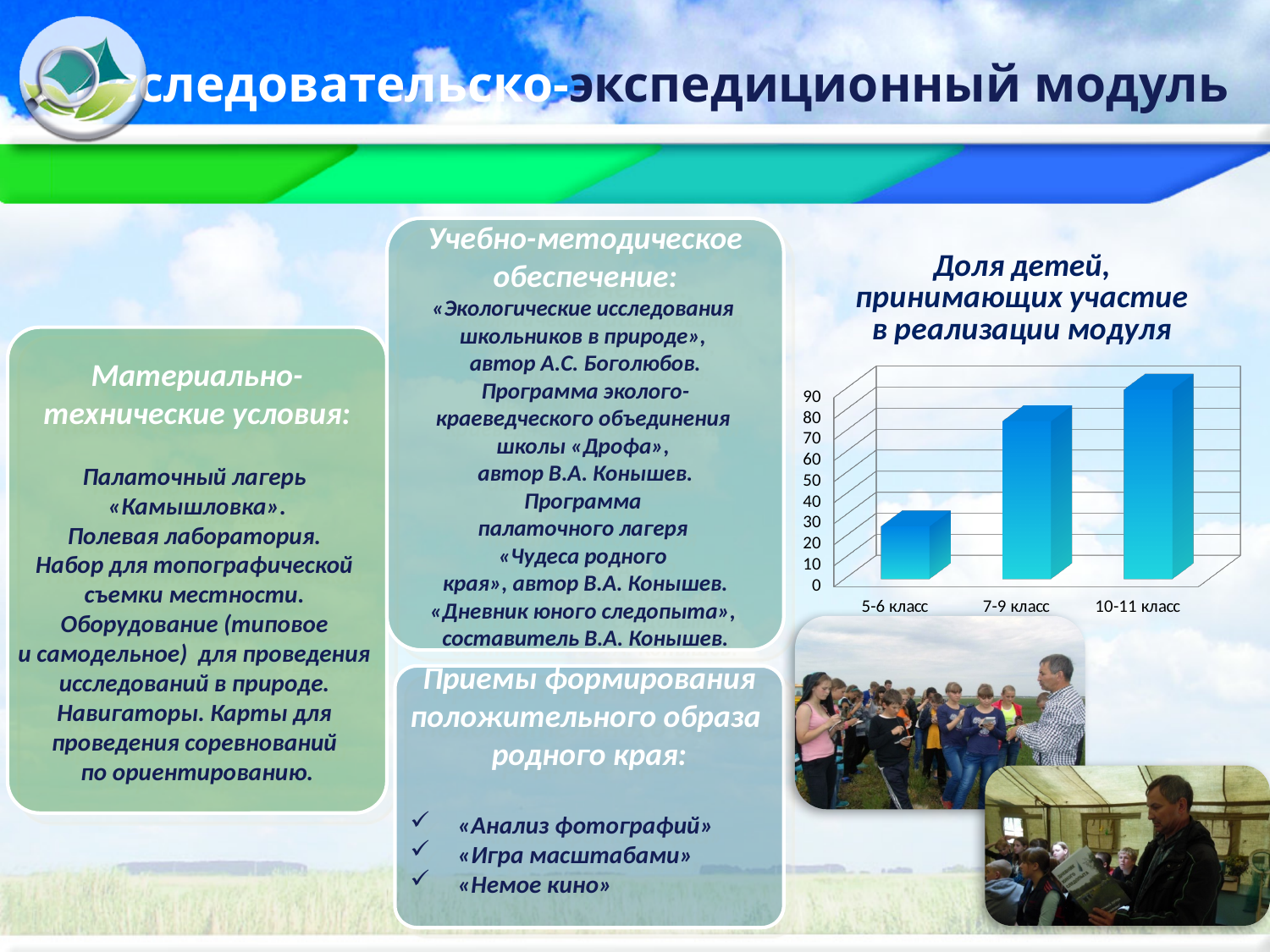
What is the title of the chart on the slide? Доля детей, принимающих участие в реализации модуля What is the highest tick value shown on the vertical axis of the chart? 90 How many categories are shown on the x axis of the chart? 3 Is the value for 10-11 класс greater or less than 70? greater Which category has the lowest bar in the chart? 5-6 класс Which category has the highest bar in the chart? 10-11 класс Is the value for 7-9 класс greater or less than 60? greater Is the value for 5-6 класс greater or less than 50? less Do the bar values rise or fall from 5-6 класс to 10-11 класс? rise Which is larger in the chart: the value for 7-9 класс or the value for 5-6 класс? 7-9 класс What kind of chart is shown on the slide? bar chart